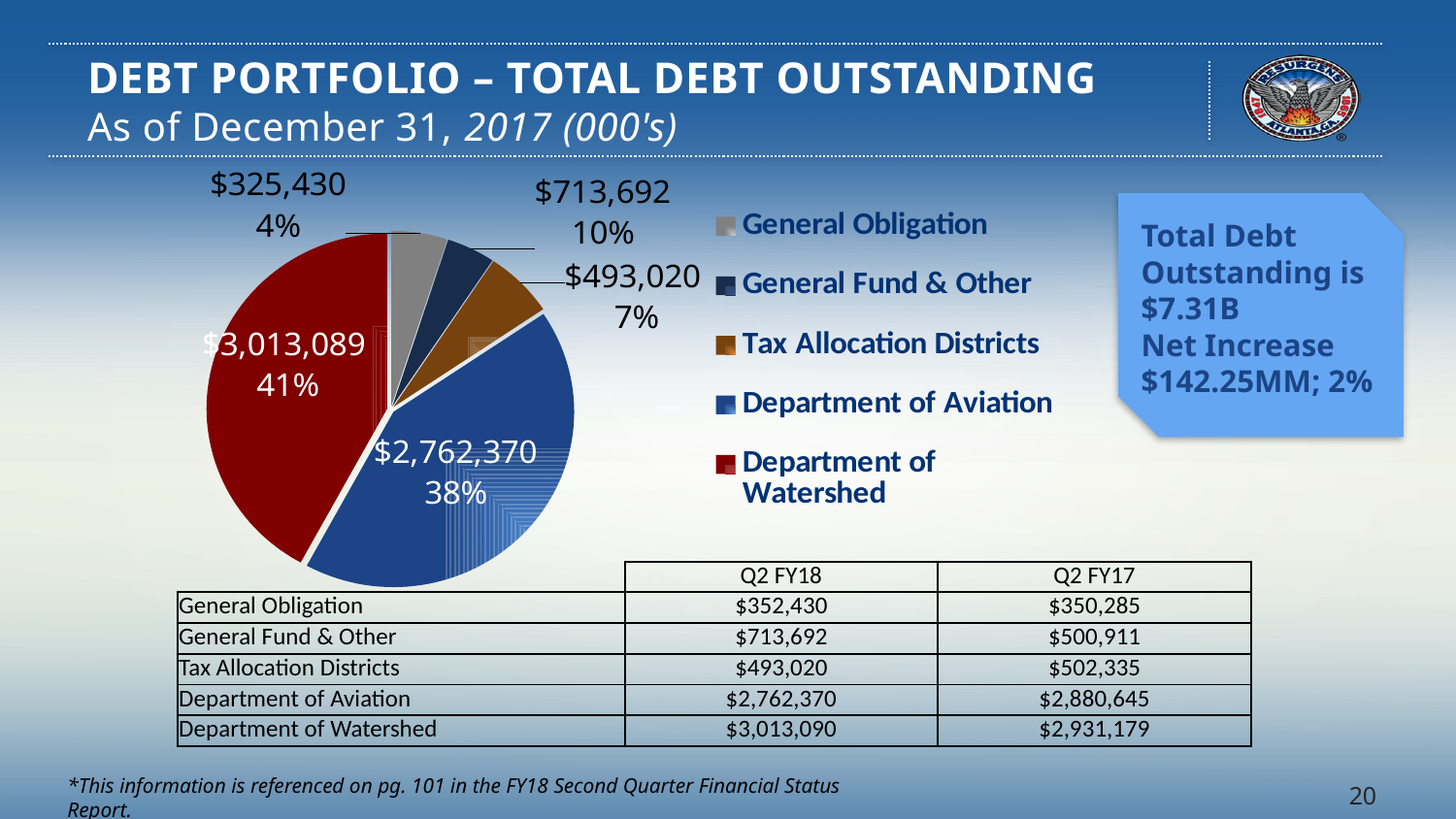
According to the pie chart's data label, what is the value for Department of Aviation? $2,762,370 According to the pie chart's data label, what is the value for General Fund & Other? $713,692 How many entries does the pie chart's legend list? 5 Which category has the largest slice of the pie chart? Department of Watershed Which category has the smallest slice of the pie chart? General Obligation What kind of chart is shown on the slide? pie chart Based on the pie chart's data labels, what is the difference between the Department of Watershed value and the Department of Aviation value? $250,719 How many slices does the pie chart have? 5 According to the pie chart's data label, what is the value for Tax Allocation Districts? $493,020 According to the pie chart's data label, what is the value for Department of Watershed? $3,013,089 What share of the pie does General Obligation represent? 4% What share of the pie does Department of Aviation represent? 38%